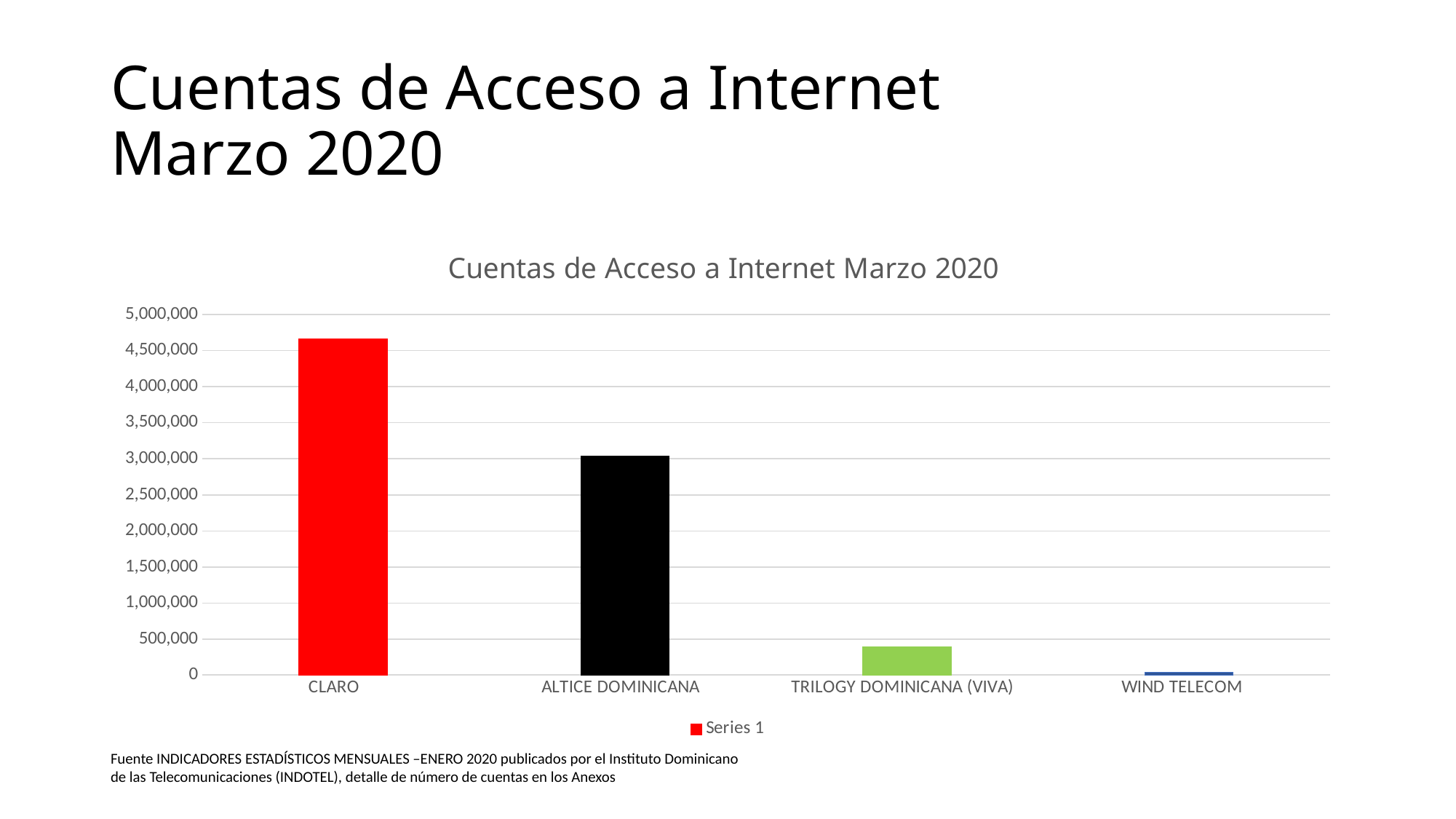
Which category has the highest value? CLARO Is the value for CLARO greater or less than 4,500,000? greater How many categories are shown on the x axis of the chart? 4 Which category has the lowest value? WIND TELECOM Which is larger, the value for TRILOGY DOMINICANA (VIVA) or the value for WIND TELECOM? TRILOGY DOMINICANA (VIVA) Which is larger, the value for CLARO or the value for ALTICE DOMINICANA? CLARO How many series does the legend list? 1 Is the value for TRILOGY DOMINICANA (VIVA) greater or less than 500,000? less Is the value for ALTICE DOMINICANA greater or less than 3,500,000? less What kind of chart is shown on the slide? bar chart What is the title of the chart? Cuentas de Acceso a Internet Marzo 2020 What is the name of the series shown in the legend? Series 1